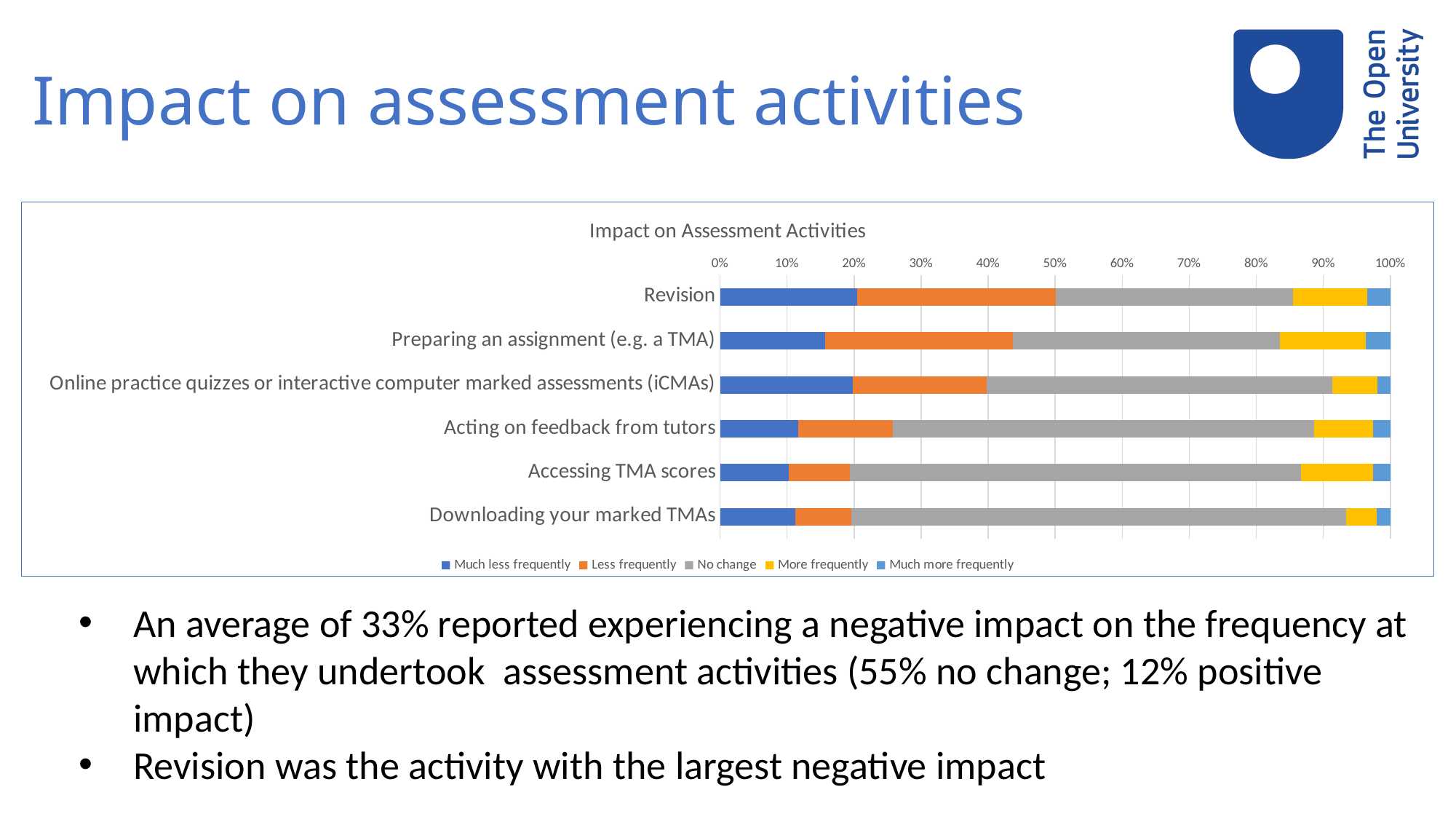
What kind of chart is shown on the slide? Stacked bar chart Which activity has the smallest 'No change' segment? Revision How many assessment activities (categories) are plotted in the chart? 6 Is the 'Much less frequently' value for Revision greater or less than 10%? greater Which activity has the largest 'No change' segment? Downloading your marked TMAs Which has the larger 'Less frequently' segment: Revision or Downloading your marked TMAs? Revision Is the 'No change' value for Downloading your marked TMAs greater or less than 60%? greater Which colour represents the 'No change' series in the chart? Grey Is the 'Less frequently' value for Revision greater or less than 20%? greater What is the title of the chart? Impact on Assessment Activities How many series does the chart legend list? 5